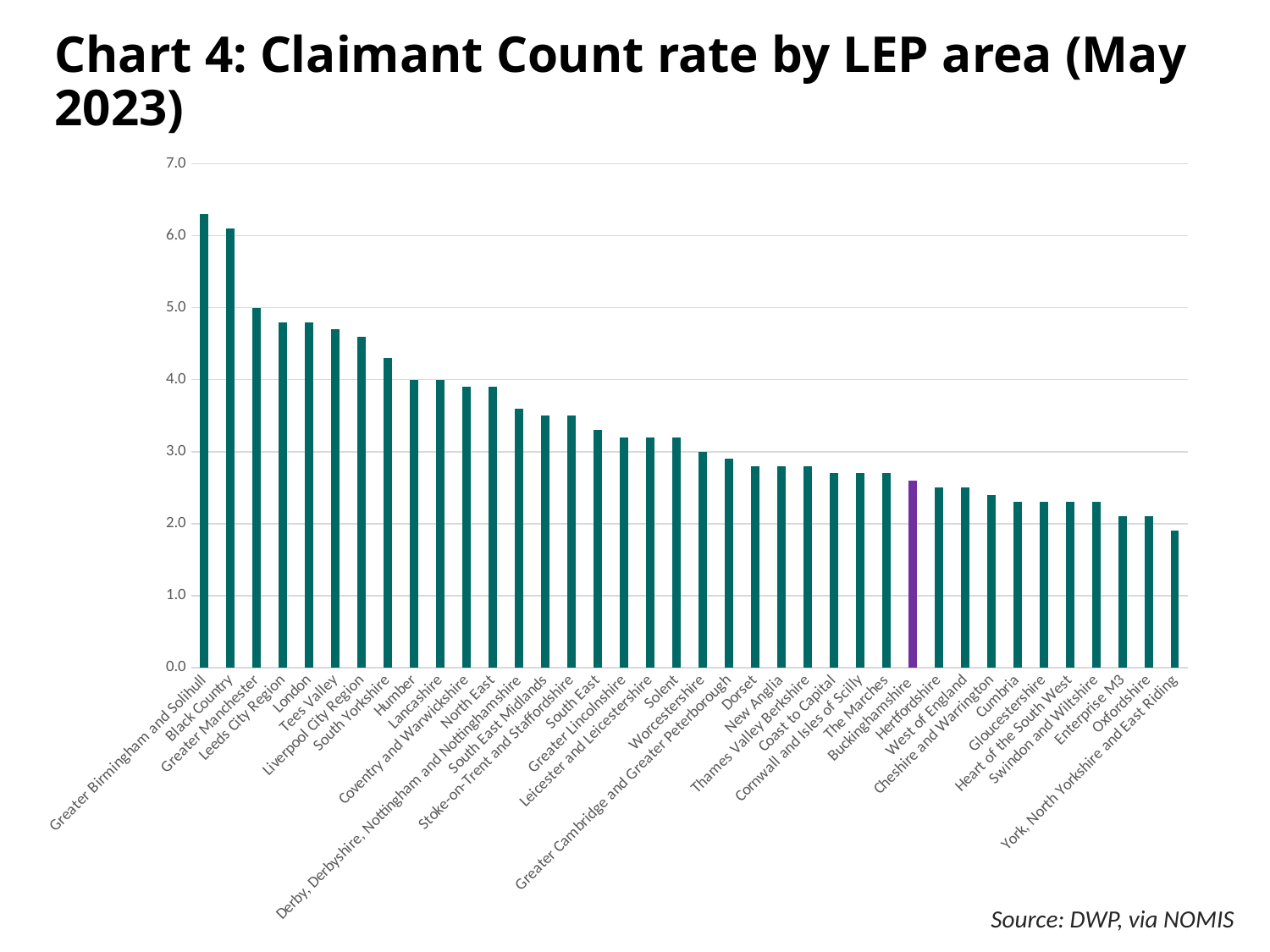
Which has the higher Claimant Count rate, Tees Valley or Dorset? Tees Valley Is the Claimant Count rate for London greater or less than 5.0? less How many LEP areas are plotted on the chart? 38 Which LEP area has the lowest Claimant Count rate? York, North Yorkshire and East Riding Which LEP area's bar is shown in purple rather than green? Buckinghamshire Is the Claimant Count rate for Oxfordshire greater or less than 2.0? greater Do the Claimant Count rates rise or fall moving from left to right along the x axis? Fall What is the title of the chart? Chart 4: Claimant Count rate by LEP area (May 2023) Which LEP area has the highest Claimant Count rate? Greater Birmingham and Solihull Is the Claimant Count rate for South Yorkshire greater or less than 4.0? greater What kind of chart is shown on the slide? Bar chart